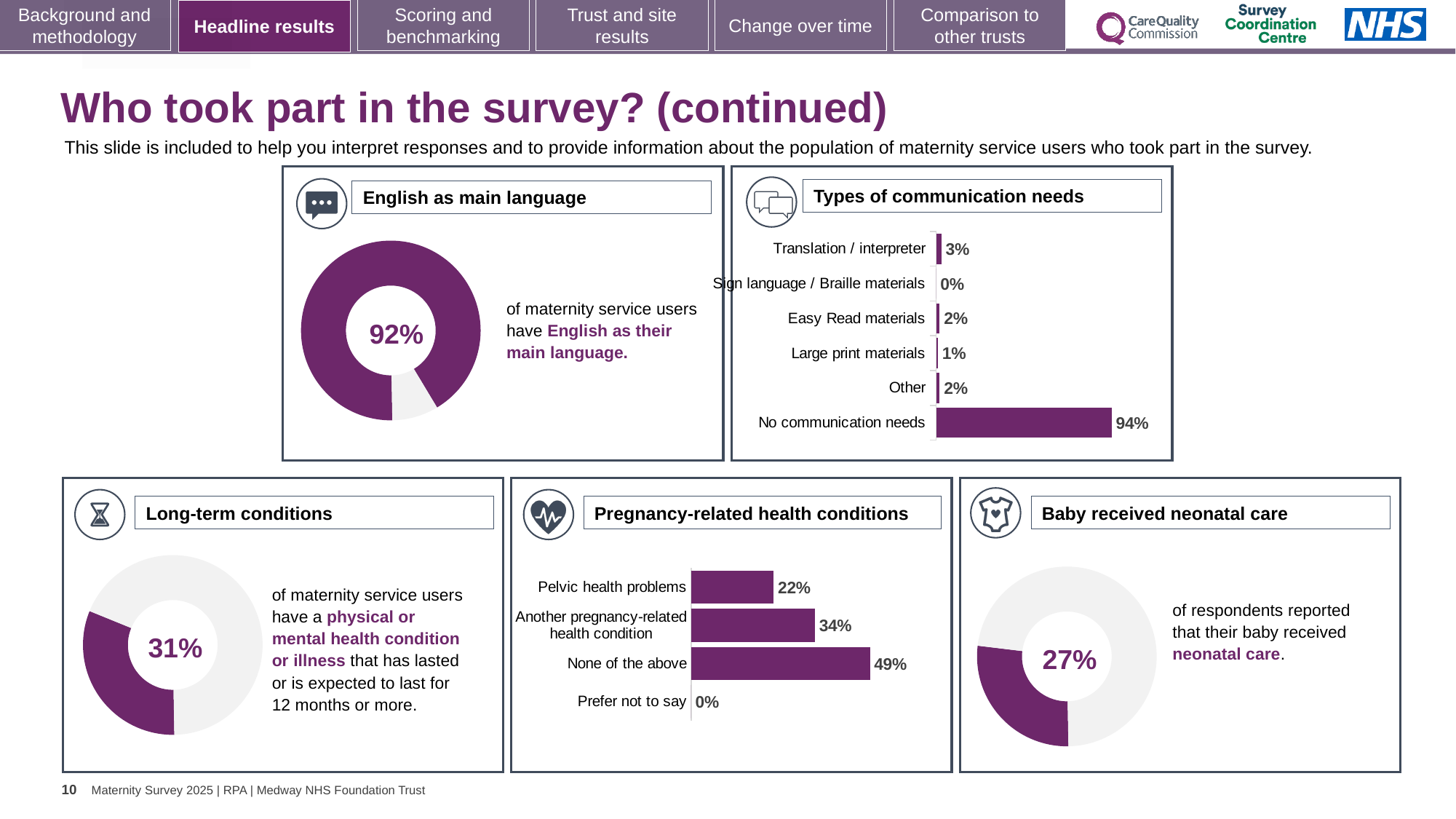
In the 'Types of communication needs' chart, what is the difference between No communication needs and Translation / interpreter? 91% In the 'Types of communication needs' chart, what is the value for Large print materials? 1% In the 'Pregnancy-related health conditions' chart, which category has the highest value? None of the above In the 'Types of communication needs' chart, which category has the highest value? No communication needs In the 'Pregnancy-related health conditions' chart, what is the difference between None of the above and Another pregnancy-related health condition? 15% In the 'Pregnancy-related health conditions' chart, what is the value for Pelvic health problems? 22% What kind of chart is the 'Pregnancy-related health conditions' chart? Bar chart In the 'Baby received neonatal care' chart, what percentage of respondents reported that their baby received neonatal care? 27% In the 'Types of communication needs' chart, how many categories are shown? 6 In the 'Types of communication needs' chart, what is the value for Translation / interpreter? 3% In the 'English as main language' chart, what percentage of maternity service users have English as their main language? 92% In the 'Pregnancy-related health conditions' chart, which is larger: Another pregnancy-related health condition or Pelvic health problems? Another pregnancy-related health condition